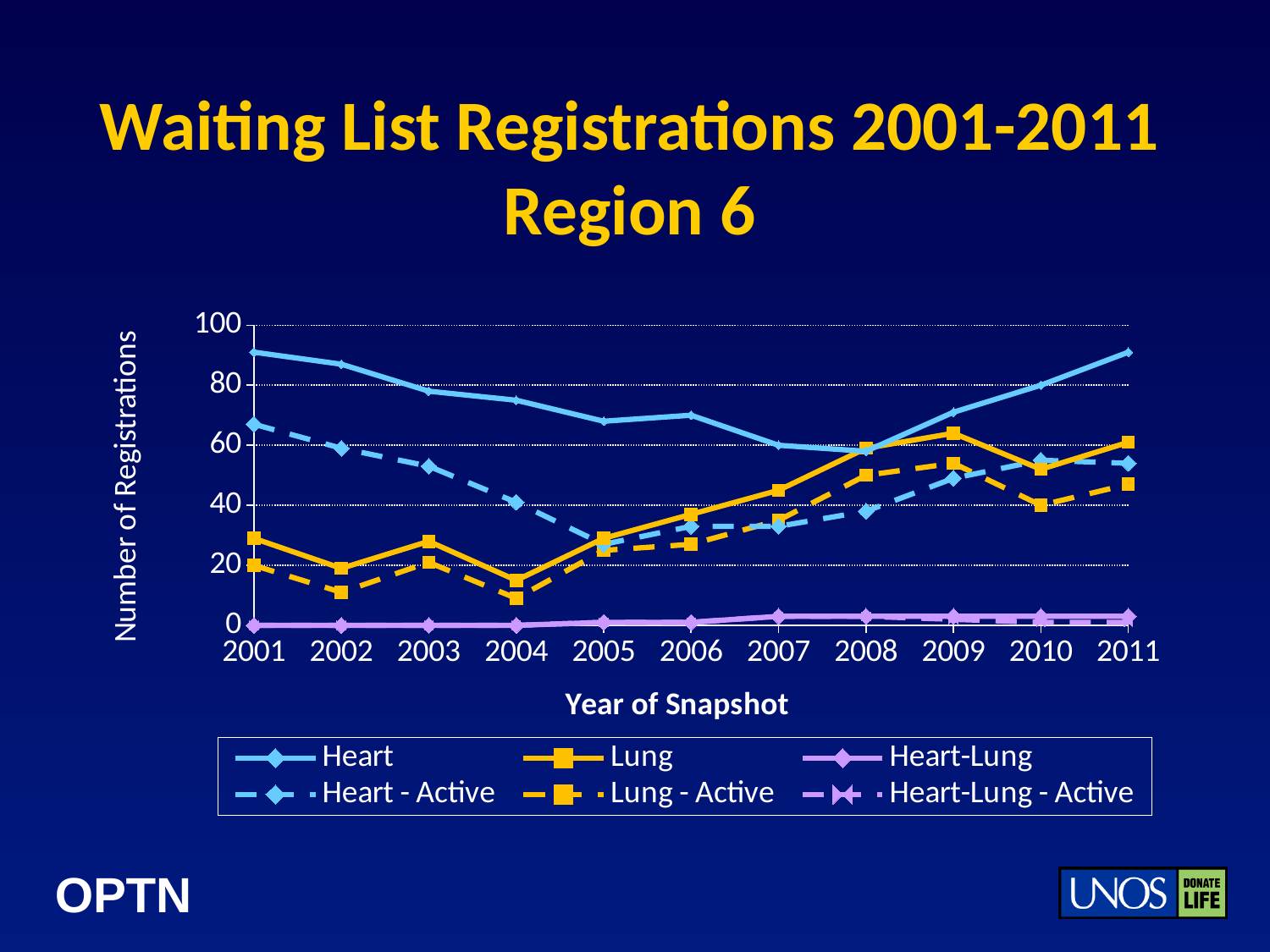
In which year does the Lung series reach its highest value? 2009 In 2009, which series is larger: Lung or Heart - Active? Lung What is the title of the x axis? Year of Snapshot How many series does the legend list? 6 Is the Heart-Lung value in 2011 greater or less than 20? less Is the Heart value in 2001 greater or less than 80? greater In 2001, which series is larger: Heart or Lung? Heart Is the Lung value in 2004 greater or less than 20? less In which year does the Heart - Active series reach its lowest value? 2005 How many years are plotted along the x axis? 11 Does the Heart - Active series rise or fall from 2001 to 2005? fall What kind of chart is shown on the slide? line chart